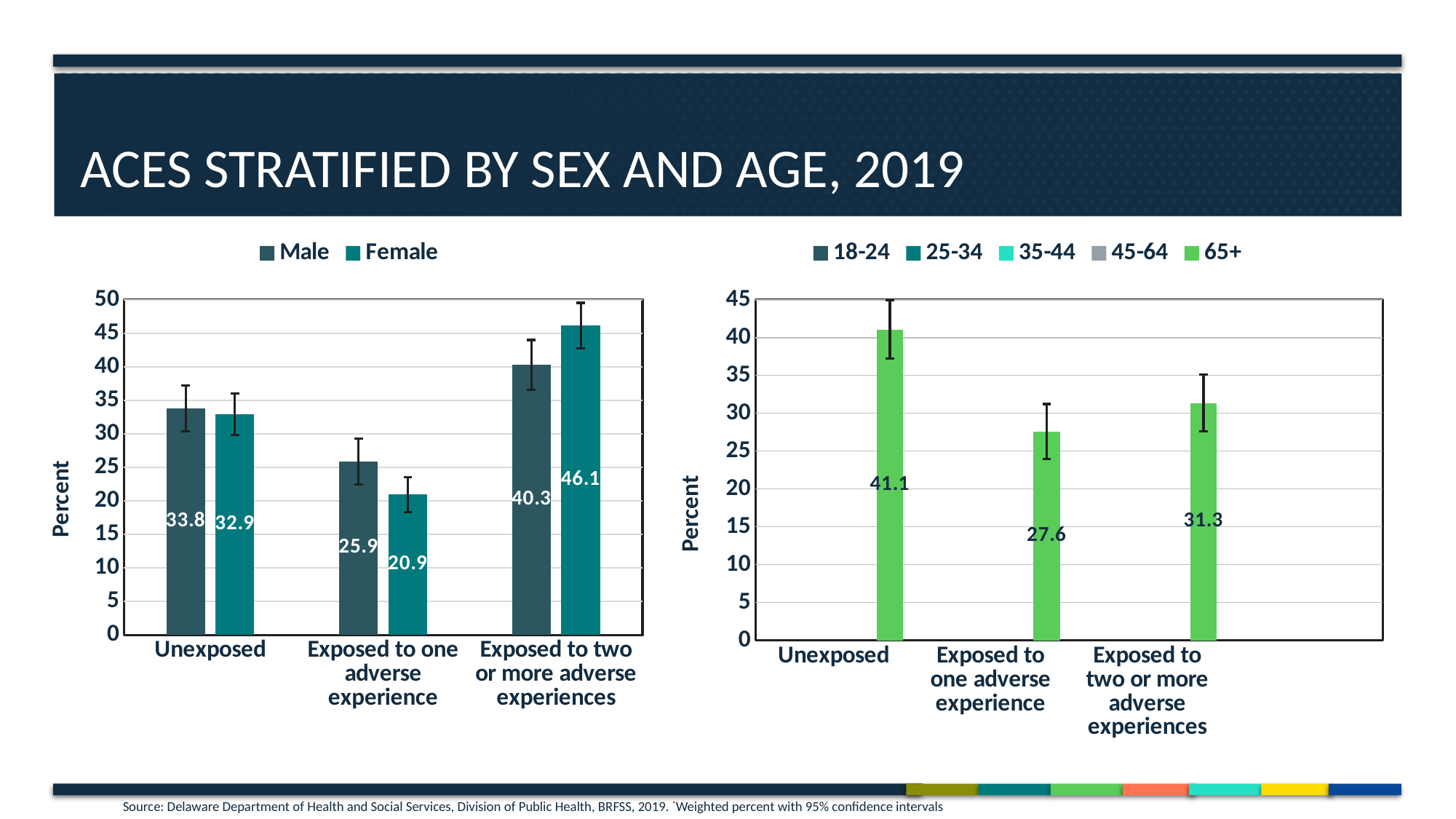
In the right chart (by age), what is the value for 65+ in the 'Exposed to one adverse experience' category? 27.6 In the right chart (by age), what is the value for 65+ in the Unexposed category? 41.1 In the left chart (by sex), which category has the lowest Female value? Exposed to one adverse experience In the left chart (by sex), what is the value for Female in the 'Exposed to two or more adverse experiences' category? 46.1 How many series does the legend of the right chart (by age) list? 5 In the left chart (by sex), what is the value for Female in the 'Exposed to one adverse experience' category? 20.9 In the left chart (by sex), what is the value for Male in the Unexposed category? 33.8 In the left chart (by sex), which is larger for 'Exposed to one adverse experience': Male or Female? Male In the left chart (by sex), what is the difference between the Female and Male values for 'Exposed to two or more adverse experiences'? 5.8 In the left chart (by sex), which category has the highest Male value? Exposed to two or more adverse experiences In the right chart (by age), what is the difference between the 65+ values for Unexposed and 'Exposed to two or more adverse experiences'? 9.8 How many series does the legend of the left chart (by sex) list? 2